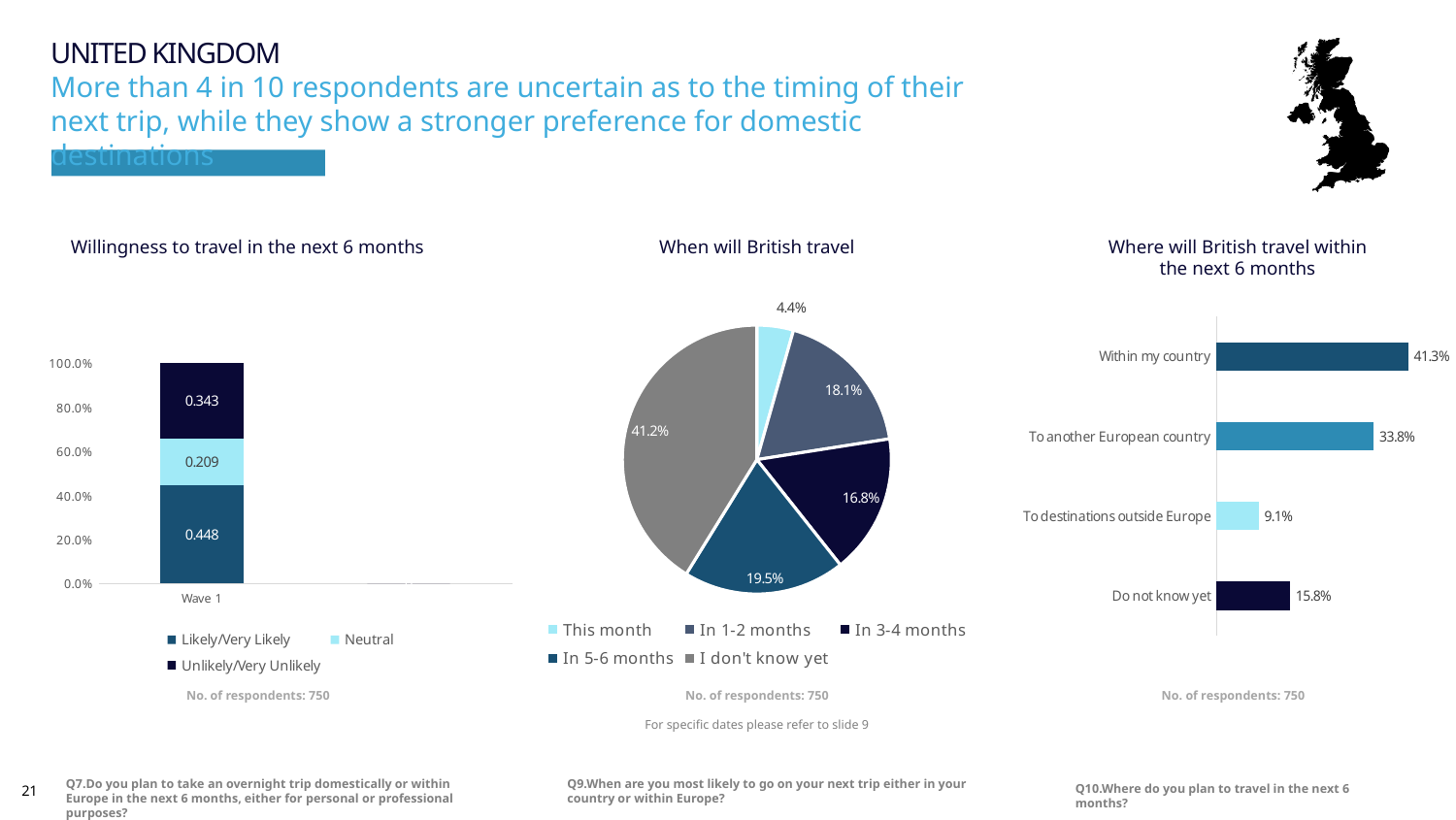
What kind of chart is 'Where will British travel within the next 6 months'? Bar chart In the 'When will British travel' chart, which slice is the smallest? This month In the 'Willingness to travel in the next 6 months' chart, what is the difference between the Likely/Very Likely and Unlikely/Very Unlikely values? 0.105 In the 'When will British travel' chart, what is the value for 'In 5-6 months'? 19.5% In the 'Willingness to travel in the next 6 months' chart, what is the value for Neutral in Wave 1? 0.209 In the 'Willingness to travel in the next 6 months' chart, how many series does the legend list? 3 In the 'Willingness to travel in the next 6 months' chart, what is the value for Likely/Very Likely in Wave 1? 0.448 In the 'When will British travel' chart, what share of the pie is 'I don't know yet'? 41.2% In the 'Where will British travel within the next 6 months' chart, which is larger: 'To another European country' or 'Do not know yet'? To another European country In the 'Where will British travel within the next 6 months' chart, what is the value for 'To destinations outside Europe'? 9.1% In the 'When will British travel' chart, how many slices does the pie have? 5 In the 'Where will British travel within the next 6 months' chart, which category has the highest value? Within my country